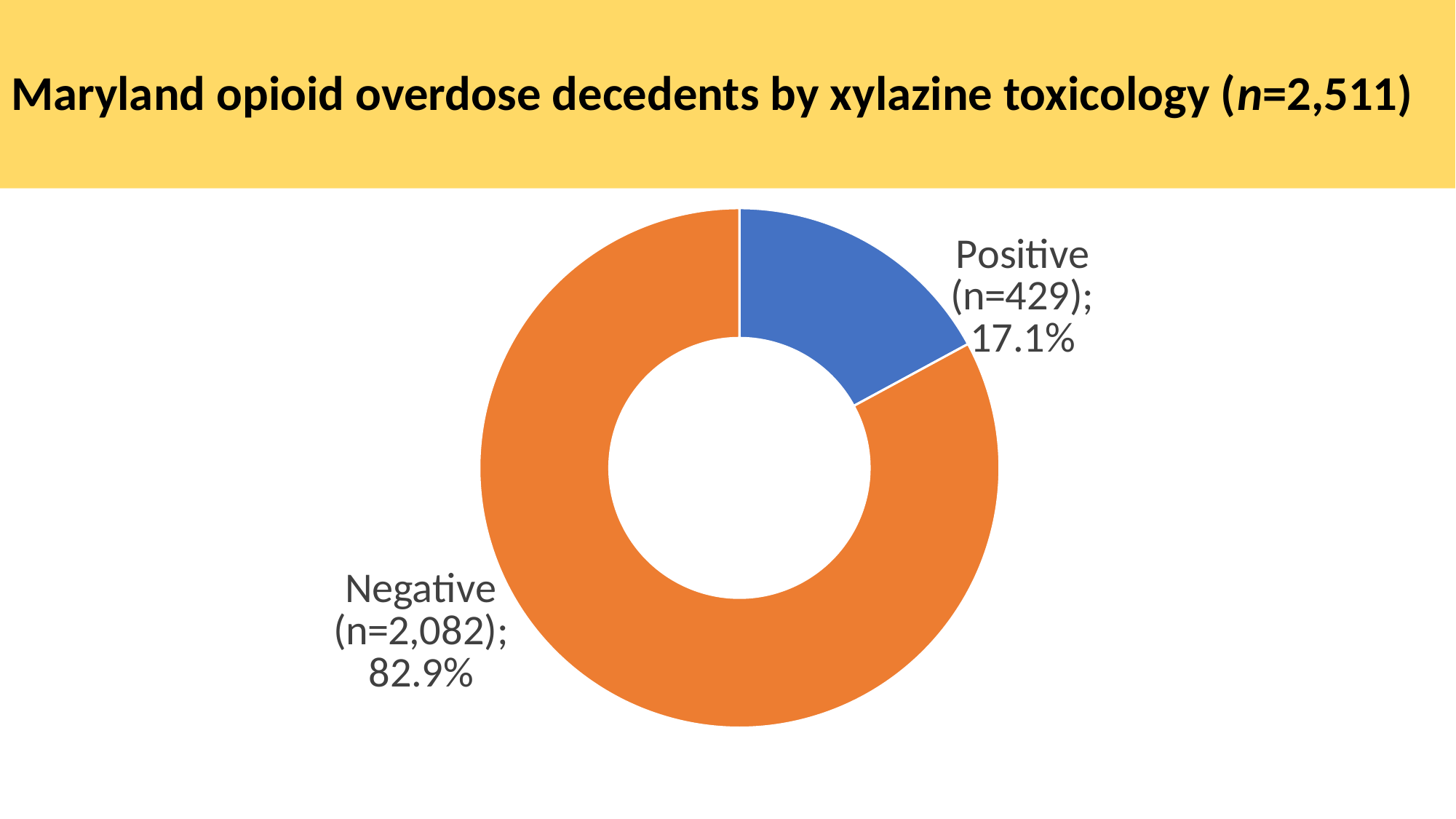
What percentage of decedents tested negative for xylazine? 82.9% How many categories does the chart show? 2 What is the total number of decedents shown in the chart title? 2,511 Which category has the smallest slice? Positive What colour is the Positive slice? Blue What percentage of decedents tested positive for xylazine? 17.1% How many decedents tested negative for xylazine? 2,082 What kind of chart is shown on the slide? Doughnut (pie) chart How many decedents tested positive for xylazine? 429 What is the difference in count between the Negative and Positive categories? 1,653 Which category has the larger share of the chart, Positive or Negative? Negative What is the title of the chart? Maryland opioid overdose decedents by xylazine toxicology (n=2,511)